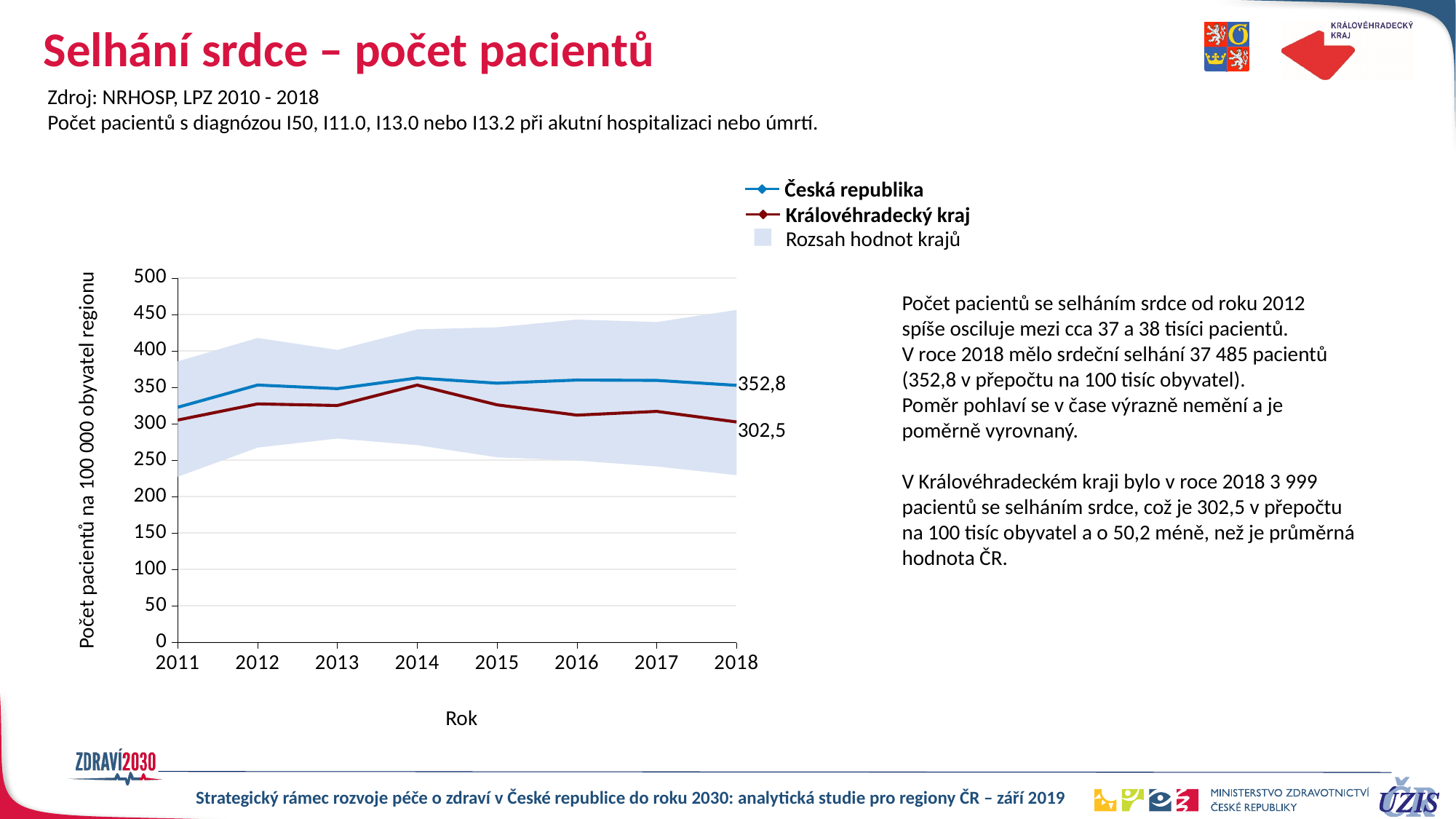
In 2018, which series has the higher value, Česká republika or Královéhradecký kraj? Česká republika How many entries does the legend list? 3 What is the value for Královéhradecký kraj in 2018? 302,5 Is the value for Královéhradecký kraj in 2011 greater or less than 350? less Is the value for Česká republika in 2011 greater or less than 300? greater What is the title of the x axis? Rok How many years are shown on the x axis? 8 What kind of chart is shown on the slide? line chart Does the Česká republika line rise or fall from 2011 to 2012? rise In which year does Česká republika have its lowest value? 2011 In which year does Královéhradecký kraj reach its highest value? 2014 What is the value for Česká republika in 2018? 352,8